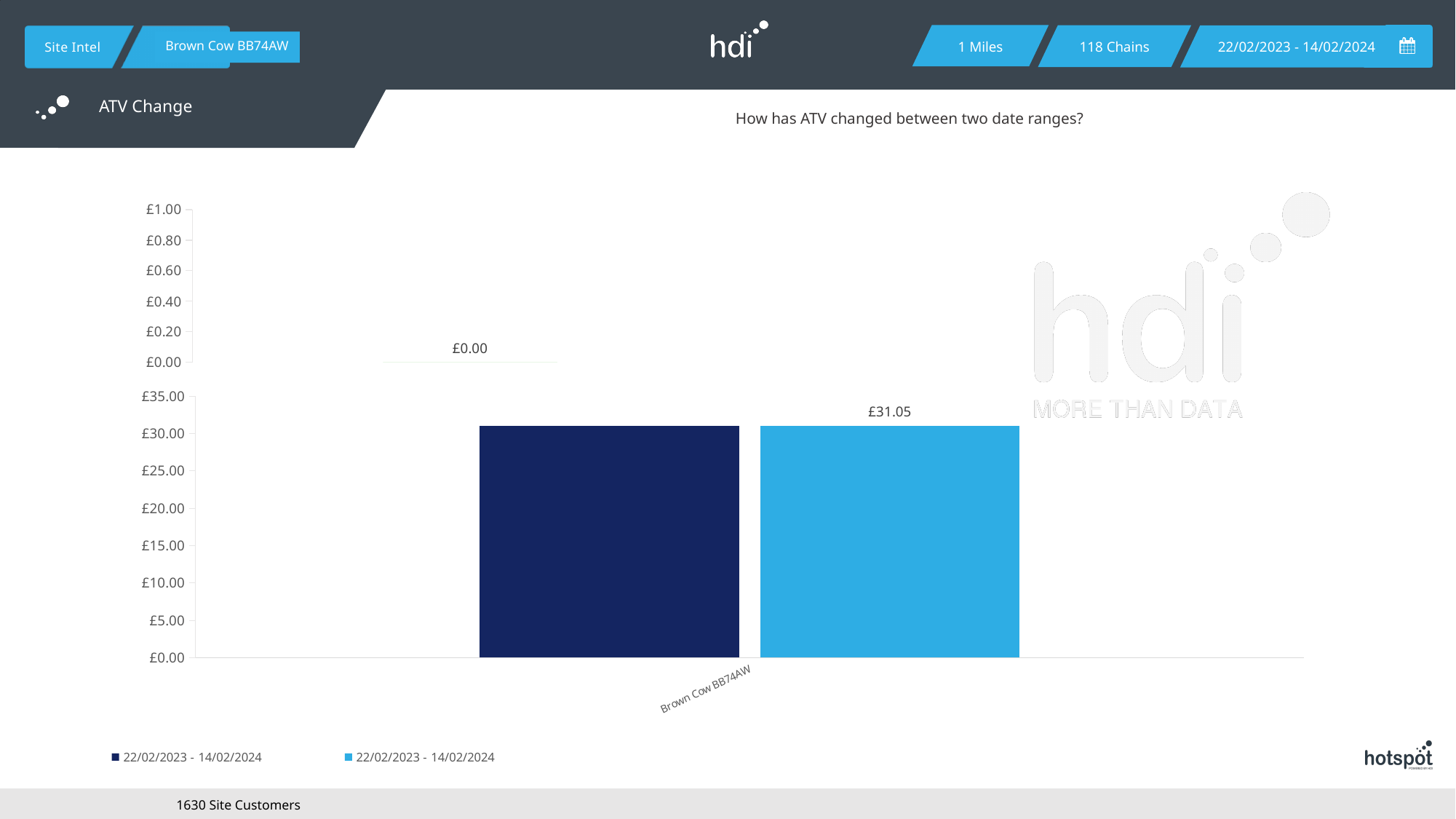
In the lower chart, what value is labelled on the light blue bar for Brown Cow BB74AW? £31.05 What is the category label on the x axis of the lower chart? Brown Cow BB74AW What is the highest tick value shown on the y axis of the lower chart? £35.00 In the lower chart, is the value of the dark blue bar for Brown Cow BB74AW greater or less than £20.00? greater How many categories are shown on the x axis of the lower chart? 1 What kind of chart is shown on the slide? bar chart In the lower chart, is the value of the dark blue bar for Brown Cow BB74AW greater or less than £25.00? greater What is the title of the chart on the slide? ATV Change How many series does the legend list? 2 In the upper chart, what value is printed as the data label? £0.00 In the lower chart, is the value of the light blue bar for Brown Cow BB74AW greater or less than £35.00? less